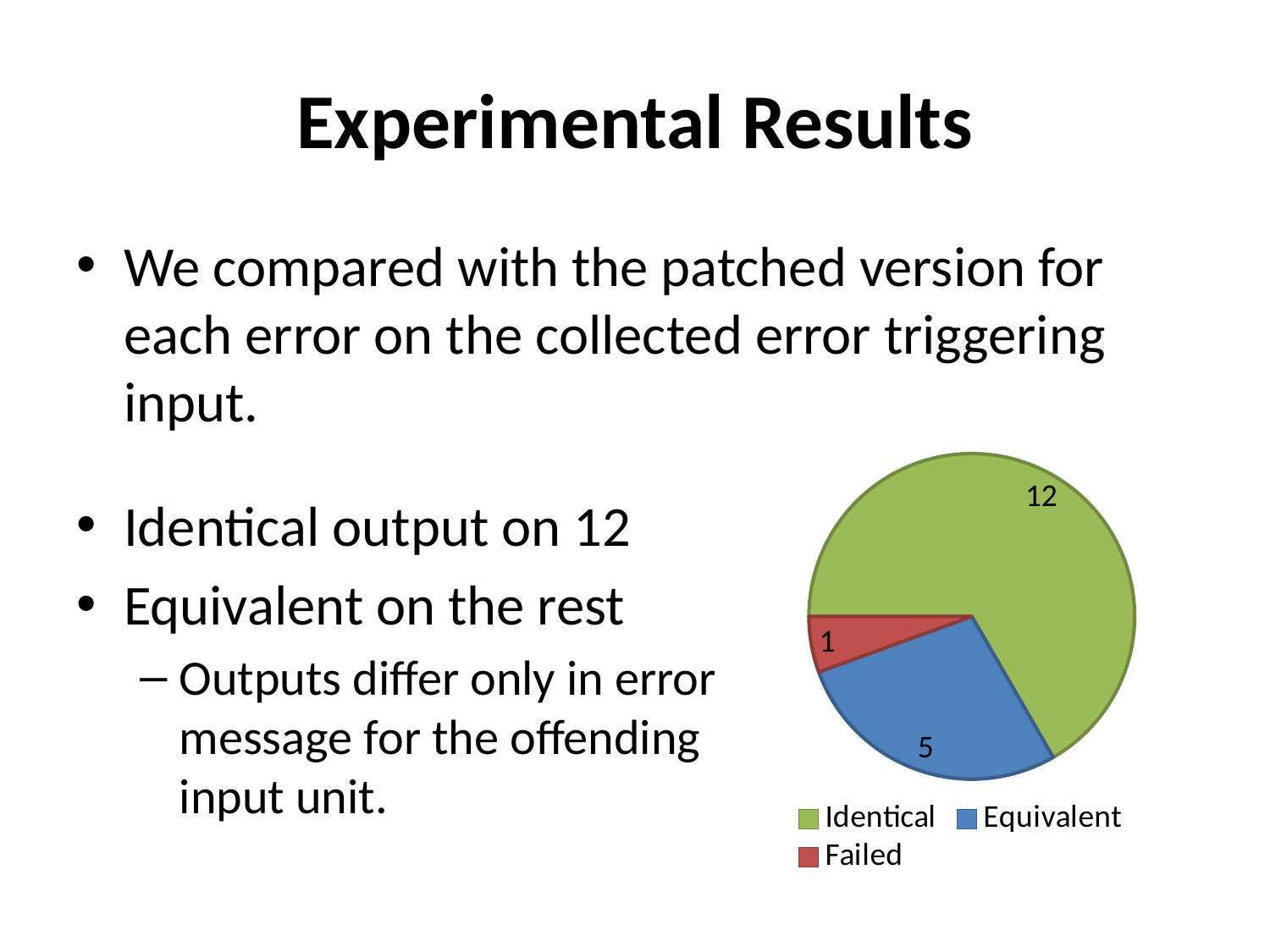
What is the value of the Identical slice in the pie chart? 12 What is the difference between the Identical and Equivalent values in the pie chart? 7 Which category has the smallest slice in the pie chart? Failed What colour is the Failed slice in the pie chart? red How many entries does the pie chart legend list? 3 How many slices does the pie chart have? 3 What is the total of all slices in the pie chart? 18 What is the value of the Failed slice in the pie chart? 1 What kind of chart is shown on the slide? pie chart Which is larger in the pie chart, Equivalent or Failed? Equivalent What is the value of the Equivalent slice in the pie chart? 5 Which category has the largest slice in the pie chart? Identical